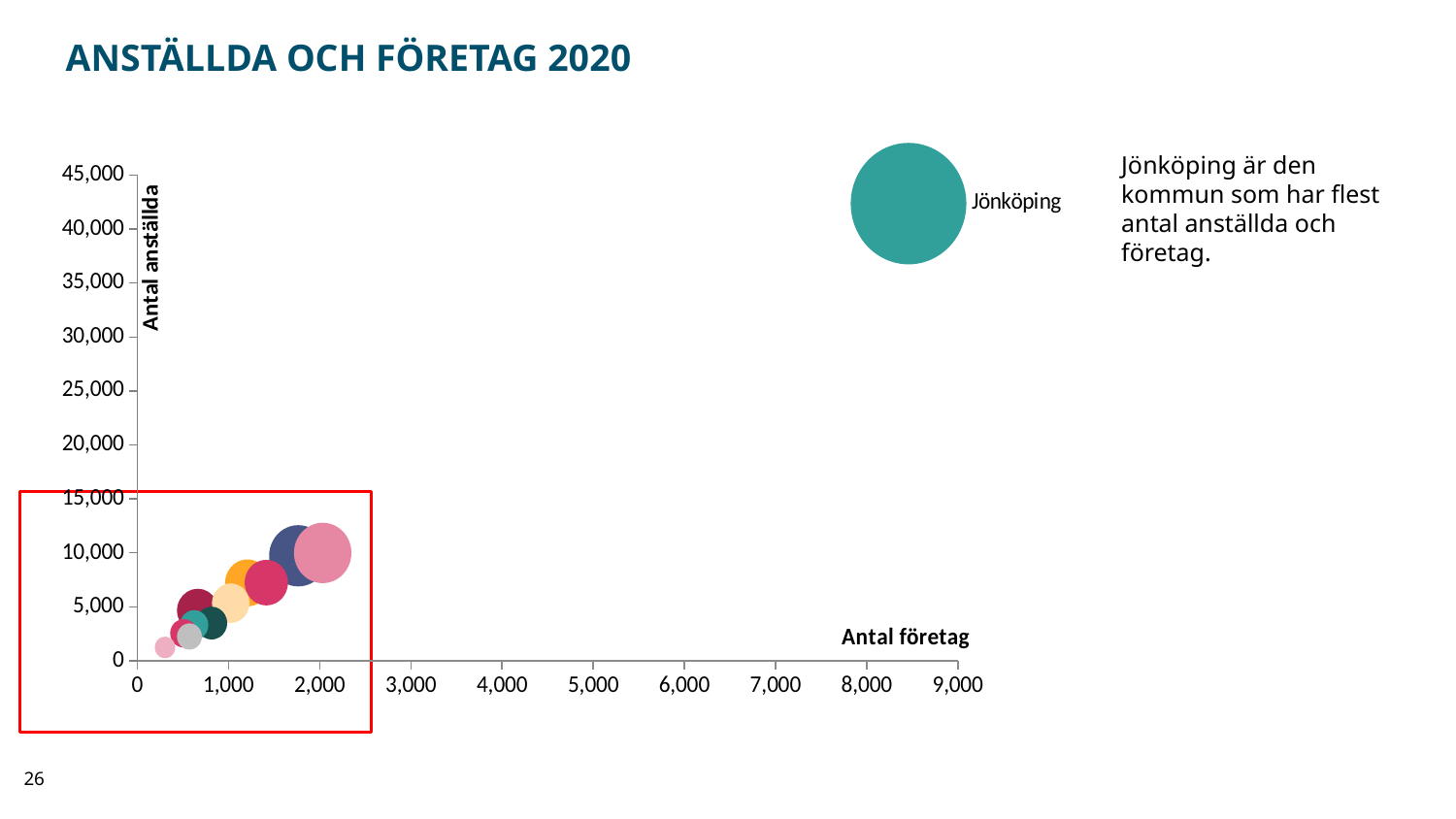
Which is the only bubble labelled with a kommun name on the chart? Jönköping Which kommun has the highest number of anställda in the chart? Jönköping Is the Antal anställda value for Jönköping greater or less than 40,000? greater What kind of chart is shown on the slide? Bubble chart What is the title of the chart on the slide? ANSTÄLLDA OCH FÖRETAG 2020 Is the Antal anställda value for Jönköping greater or less than 35,000? greater Which kommun has the highest number of företag in the chart? Jönköping Is the Antal företag value for Jönköping greater or less than 5,000? greater What are the labels of the x axis and the y axis of the chart? Antal företag (x axis) and Antal anställda (y axis)